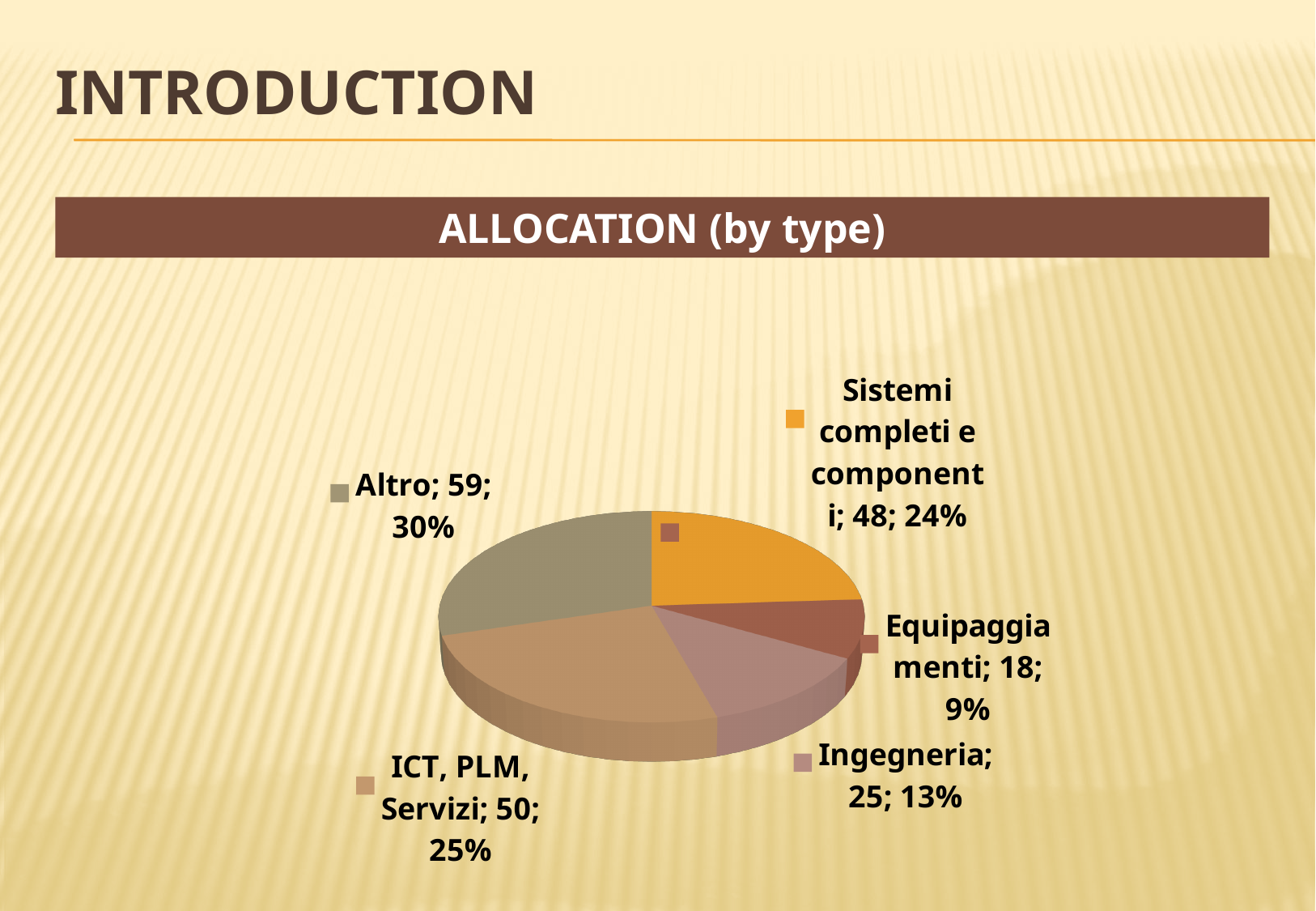
What is the value for Ingegneria? 25 What share of the pie does Altro represent? 30% Which category has the largest slice? Altro How many categories are shown in the pie chart? 5 What is the value for Sistemi completi e componenti? 48 Which category has the smallest slice? Equipaggiamenti What is the value for Altro? 59 What share of the pie does ICT, PLM, Servizi represent? 25% What is the value for Equipaggiamenti? 18 Which is larger, the value for Sistemi completi e componenti or the value for ICT, PLM, Servizi? ICT, PLM, Servizi What kind of chart is shown on the slide? pie chart What is the difference between the values for Altro and Ingegneria? 34